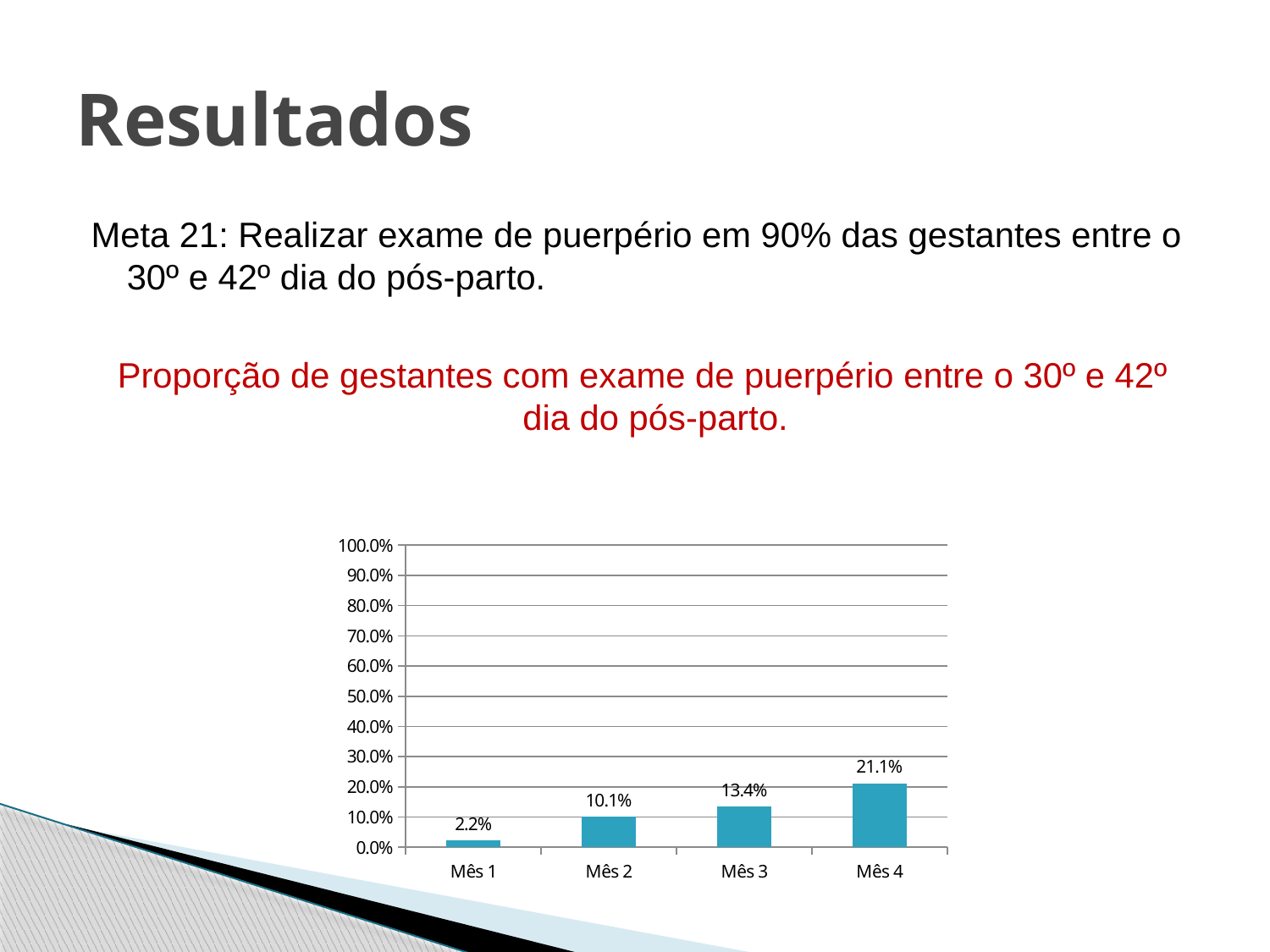
Which is larger, the value for Mês 2 or the value for Mês 3? Mês 3 What is the difference between the values for Mês 4 and Mês 1? 18.9% What kind of chart is shown on the slide? Bar chart What is the difference between the values for Mês 3 and Mês 2? 3.3% Which month has the lowest value? Mês 1 What is the value for Mês 2? 10.1% What is the value for Mês 3? 13.4% What is the value for Mês 4? 21.1% How many months are shown on the x axis? 4 Do the values rise or fall from Mês 1 to Mês 4? Rise What is the value for Mês 1? 2.2% Which month has the highest value? Mês 4